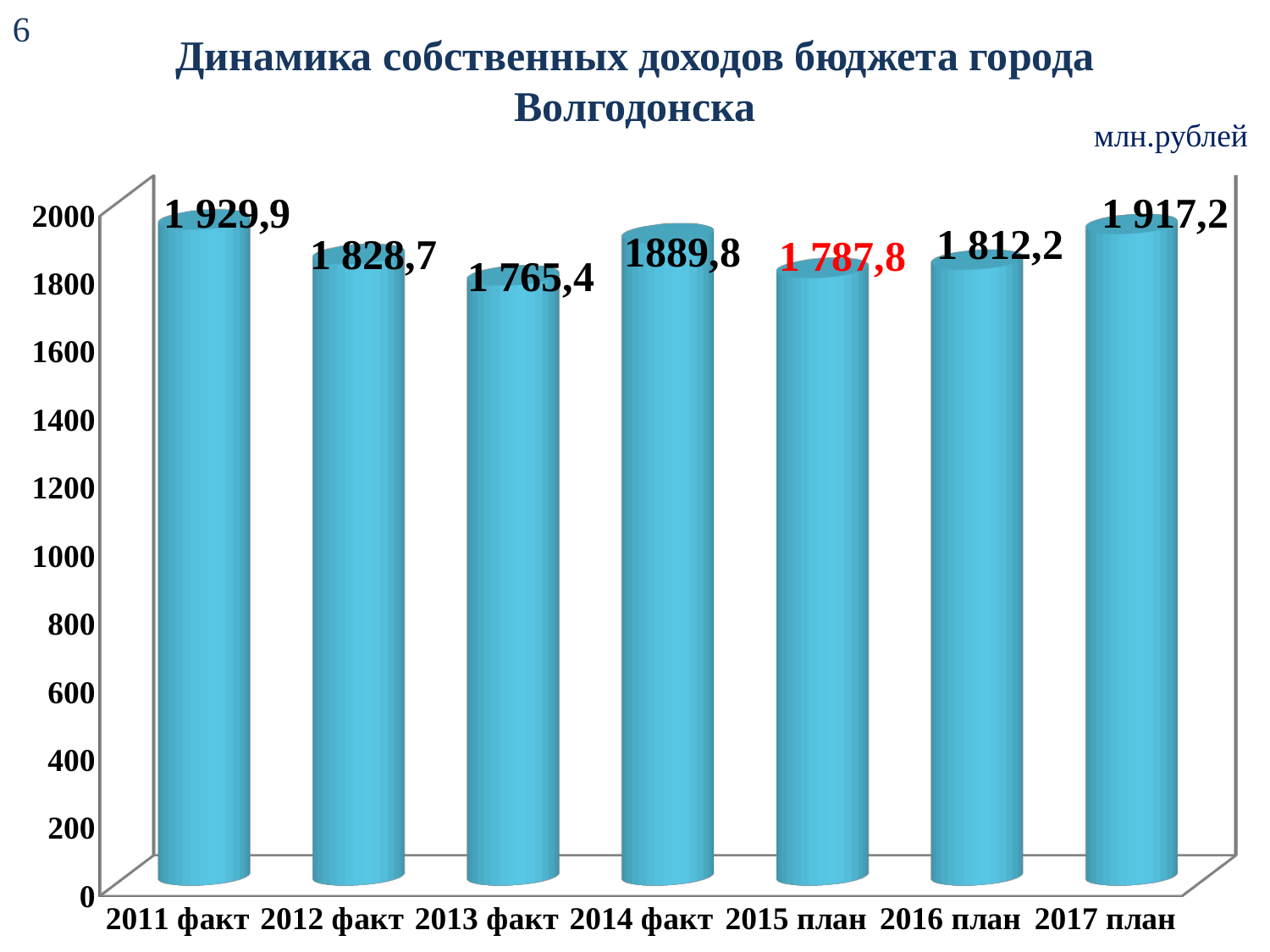
What unit is indicated for the values on the chart? млн.рублей Which category has the lowest value? 2013 факт What kind of chart is shown on the slide? bar chart What is the value for 2017 план? 1 917,2 How many categories are shown on the x axis? 7 Which category has the highest value? 2011 факт What is the difference between the values for 2012 факт and 2013 факт? 63,3 Which is larger, the value for 2016 план or the value for 2015 план? 2016 план What is the value for 2011 факт? 1 929,9 What is the difference between the values for 2014 факт and 2015 план? 102,0 Is the value for 2013 факт greater or less than 1800? less What is the value for 2015 план? 1 787,8